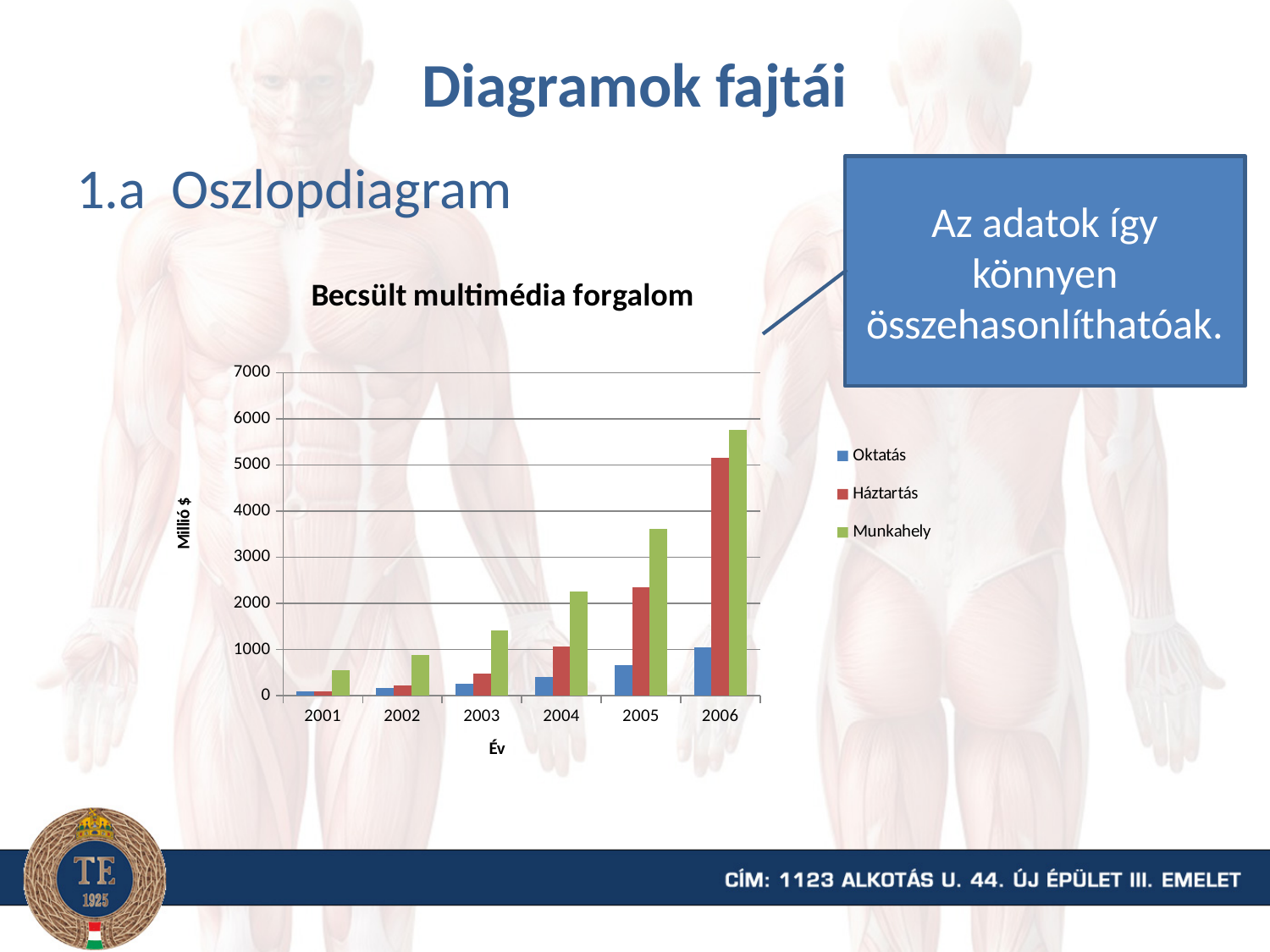
Is the value for Munkahely in 2006 greater or less than 5000? greater How many years are shown on the x axis of the chart? 6 Is the value for Oktatás in 2005 greater or less than 1000? less Which year has the lowest value for Háztartás? 2001 What is the label of the vertical axis? Millió $ What is the title of the chart? Becsült multimédia forgalom Is the value for Háztartás in 2004 greater or less than 2000? less What kind of chart is shown on the slide? bar chart How many series does the chart's legend list? 3 Do the Háztartás values rise or fall from 2001 to 2006? rise Which year has the highest value for Munkahely? 2006 In 2005, which is larger: Háztartás or Munkahely? Munkahely